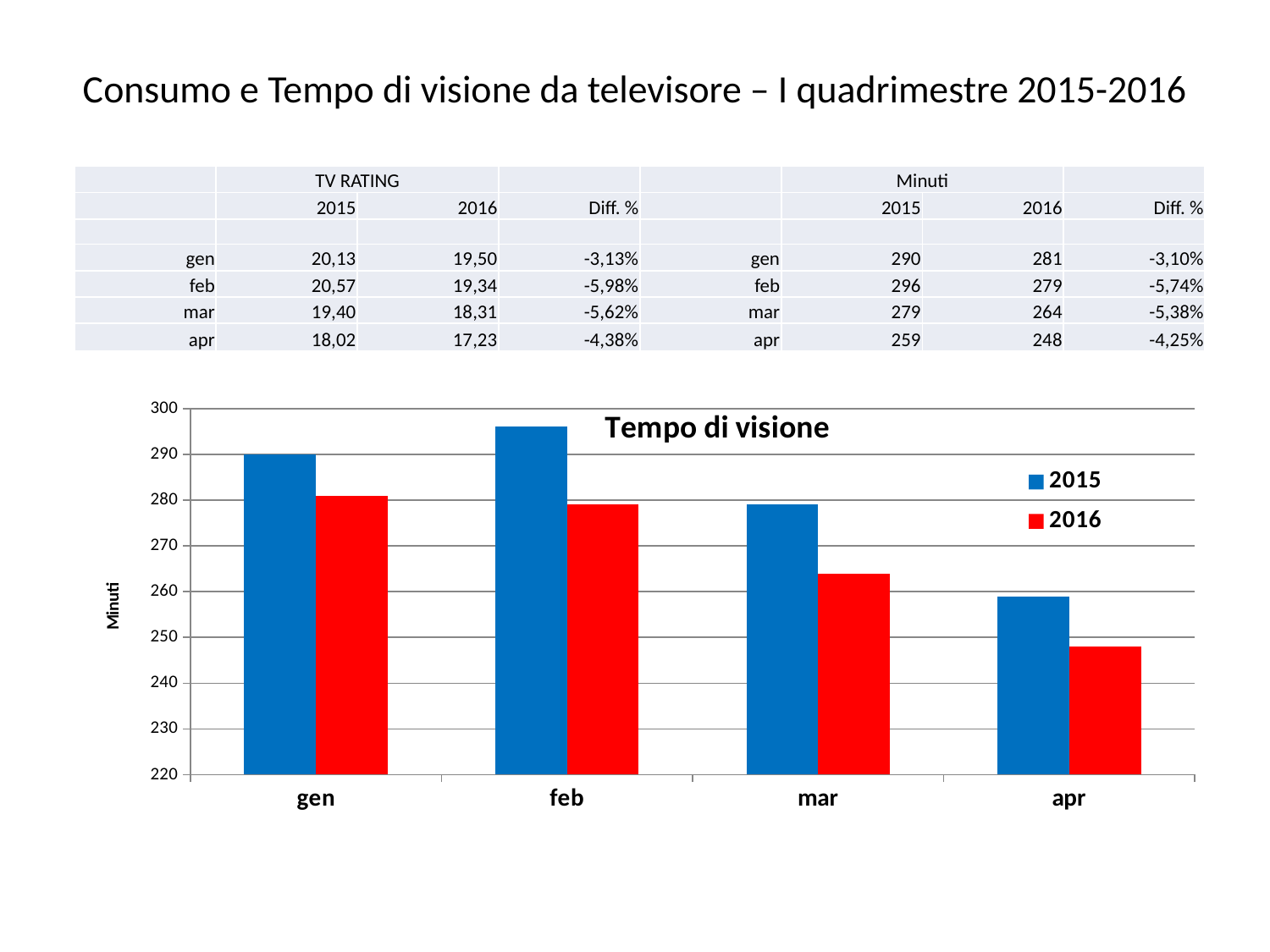
How many categories are shown on the x axis of the "Tempo di visione" chart? 4 In the "Tempo di visione" chart, is the 2016 value for mar greater or less than 270? less In the "Tempo di visione" chart, which month has the highest value in the 2015 series? feb In the "Tempo di visione" chart, what is the value for apr in the 2016 series? 248 In the "Tempo di visione" chart, which month has the lowest value in the 2016 series? apr In the "Tempo di visione" chart, what is the difference between the 2015 and 2016 values for mar? 15 In the "Tempo di visione" chart, what is the value for gen in the 2015 series? 290 In the "Tempo di visione" chart, which is larger for feb: the 2015 value or the 2016 value? 2015 What type of chart is the "Tempo di visione" chart? bar chart What is the label of the vertical axis of the "Tempo di visione" chart? Minuti How many series does the legend of the "Tempo di visione" chart list? 2 In the "Tempo di visione" chart, is the 2015 value for feb greater or less than 290? greater